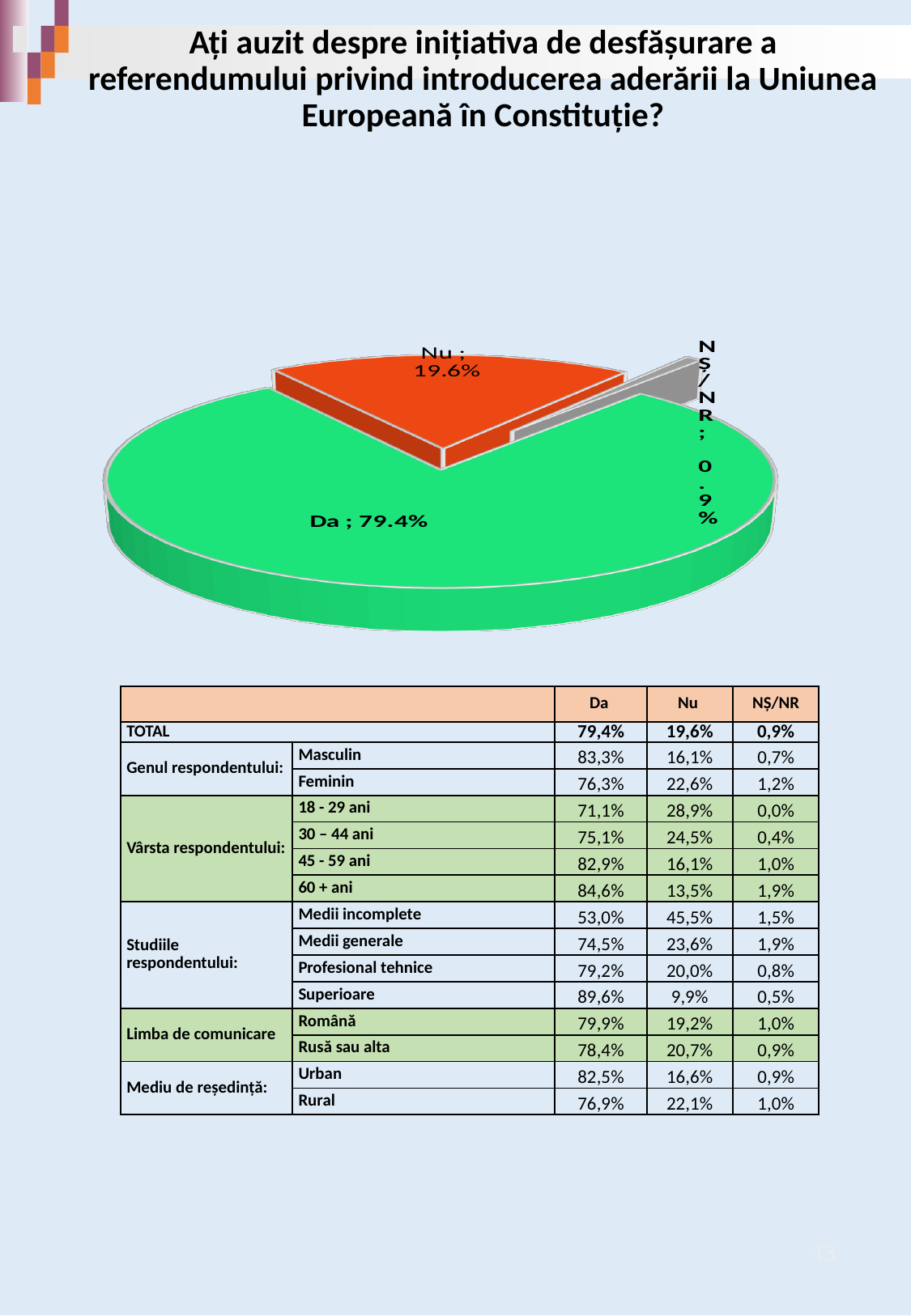
What colour is the "Da" slice in the pie chart? green Which slice of the pie chart is the smallest? NȘ/NR What is the difference between the "Da" and "Nu" slices in the pie chart? 59.8% Which slice of the pie chart is the largest? Da What share of the pie does the "Da" slice represent? 79.4% Which is larger in the pie chart, the "Nu" slice or the "NȘ/NR" slice? Nu What is the value of the "Da" slice in the pie chart? 79.4% What is the value of the "Nu" slice in the pie chart? 19.6% How many slices does the pie chart have? 3 What kind of chart is shown on the slide? pie chart What colour is the "Nu" slice in the pie chart? orange-red What is the value of the "NȘ/NR" slice in the pie chart? 0.9%